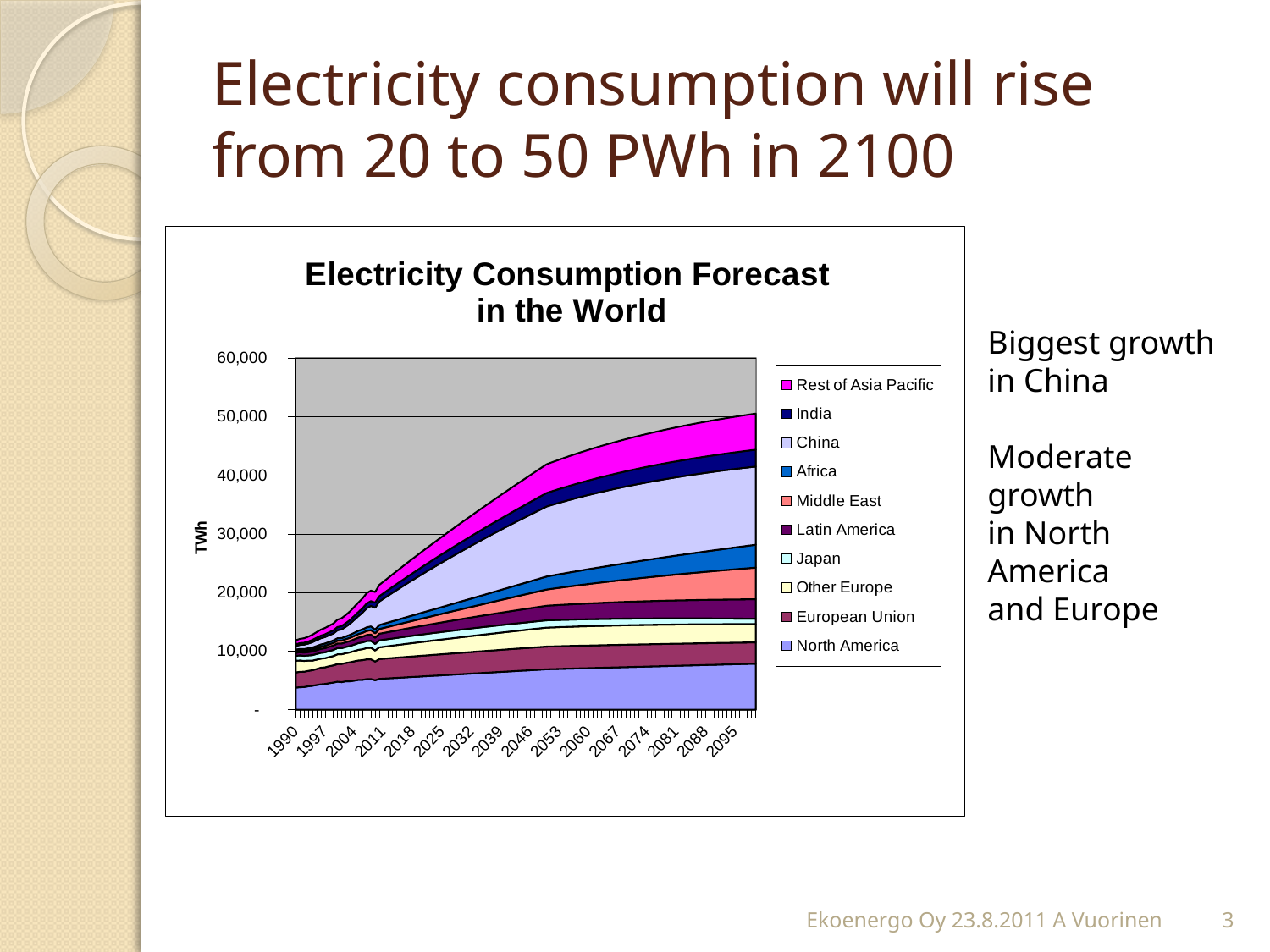
Is the total electricity consumption in 1990 greater or less than 20,000 TWh? less What is the title of the chart? Electricity Consumption Forecast in the World Is the total electricity consumption in 2095 greater or less than 60,000 TWh? less How many series does the legend of the chart list? 10 In 2095, which region's band is larger: China or Japan? China What unit is shown on the y-axis label of the chart? TWh Is the total electricity consumption in 2095 greater or less than 40,000 TWh? greater Which region has the largest electricity consumption band in 2095? China Does total electricity consumption rise or fall from 1990 to 2095 in the chart? Rises How many year labels are shown on the x-axis of the chart? 16 What kind of chart is shown on the slide? Stacked area chart